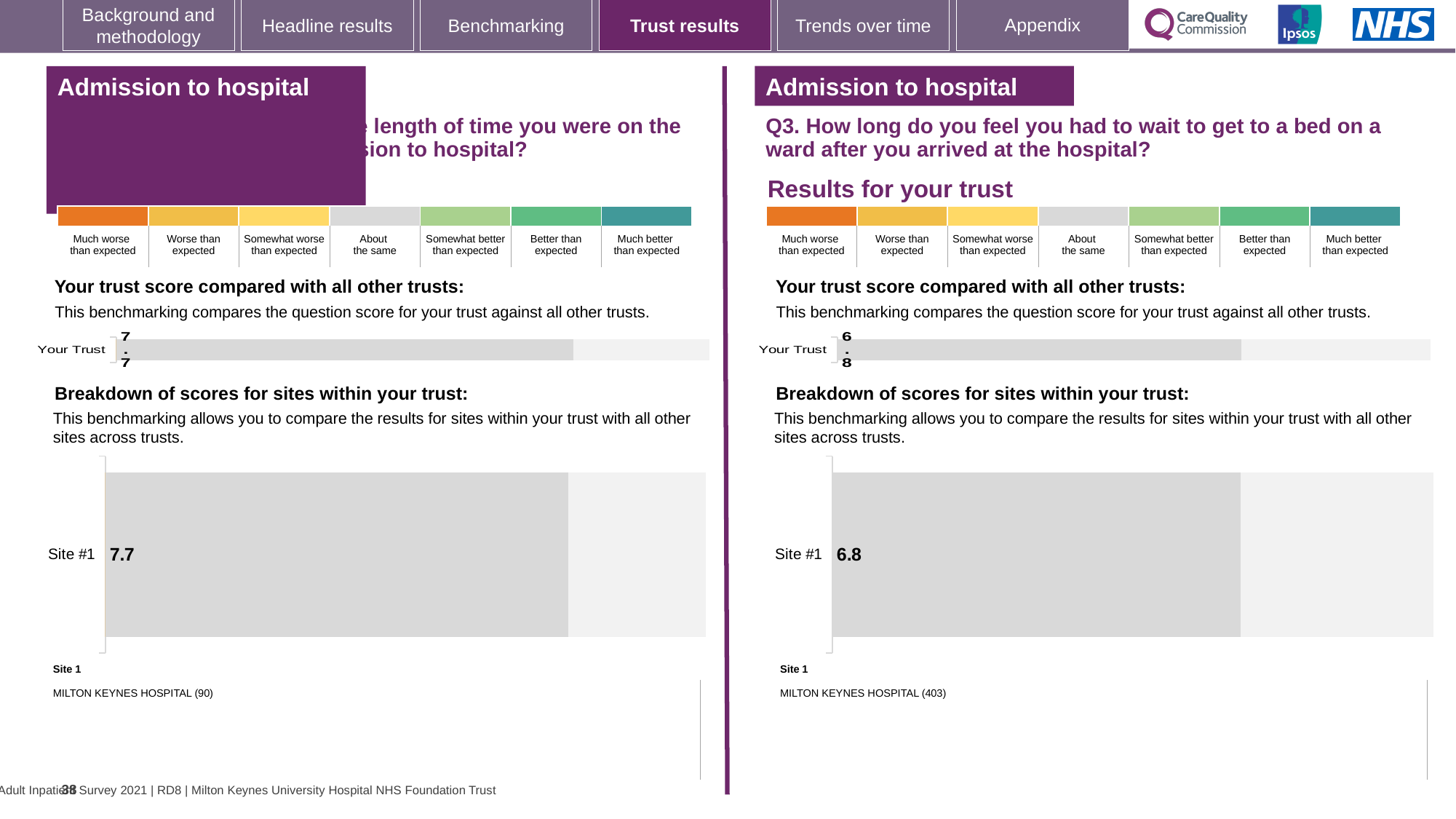
On the right panel (Q3), what is the score shown for Your Trust in the 'Your trust score compared with all other trusts' chart? 6.8 On the right panel (Q3), which site name is listed as Site 1 below the breakdown chart? MILTON KEYNES HOSPITAL (403) What type of chart is used to show the Site #1 score on the right panel (Q3)? Bar chart On the left panel, what is the score shown for Your Trust in the 'Your trust score compared with all other trusts' chart? 7.7 Which is larger: the Your Trust score on the left panel or the Your Trust score on the right panel (Q3)? Left panel (7.7) How many sites are shown in the breakdown of scores chart on the left panel? 1 On the left panel, which site name is listed as Site 1 below the breakdown chart? MILTON KEYNES HOSPITAL (90) On the right panel (Q3), what score is shown for Site #1 in the breakdown of scores for sites chart? 6.8 On the left panel, what score is shown for Site #1 in the breakdown of scores for sites chart? 7.7 How many sites are shown in the breakdown of scores chart on the right panel (Q3)? 1 What is the difference between the Site #1 score on the left panel and the Site #1 score on the right panel (Q3)? 0.9